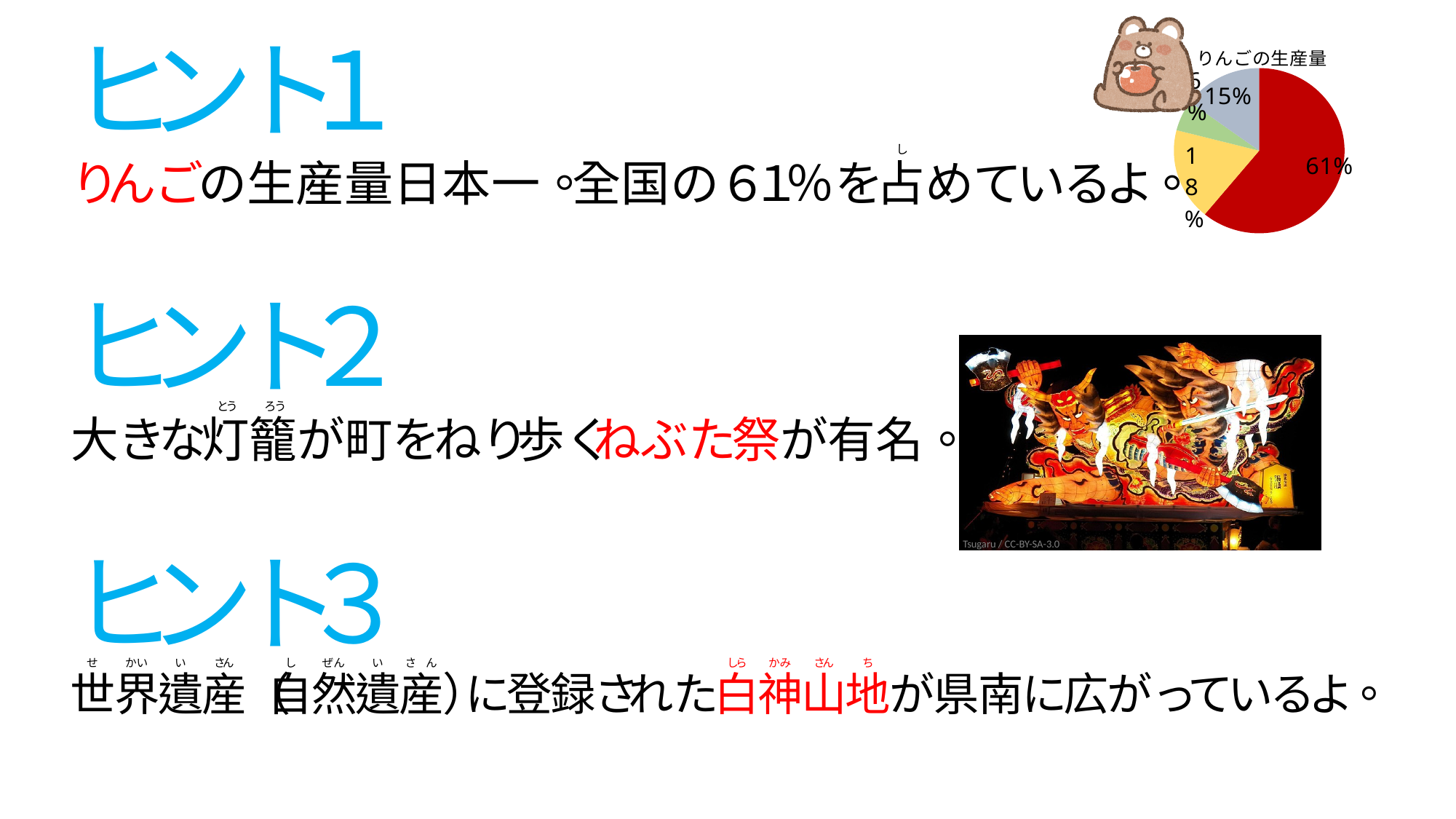
Which slice is larger in the pie chart, the red slice or the yellow slice? red slice How many slices does the pie chart have? 4 What share does the gray slice of the pie chart represent? 15% Which slice is larger in the pie chart, the yellow slice or the gray slice? yellow slice What is the difference in percentage points between the red slice (61%) and the yellow slice (18%) in the pie chart? 43 percentage points What is the share of the largest slice in the pie chart? 61% Does the largest slice of the pie chart account for more or less than half of the total? more What is the difference in percentage points between the yellow slice (18%) and the gray slice (15%) in the pie chart? 3 percentage points What is the title of the pie chart? りんごの生産量 What share does the yellow slice of the pie chart represent? 18% What kind of chart is shown in the top-right corner of the slide? pie chart What colour is the largest slice of the pie chart? red